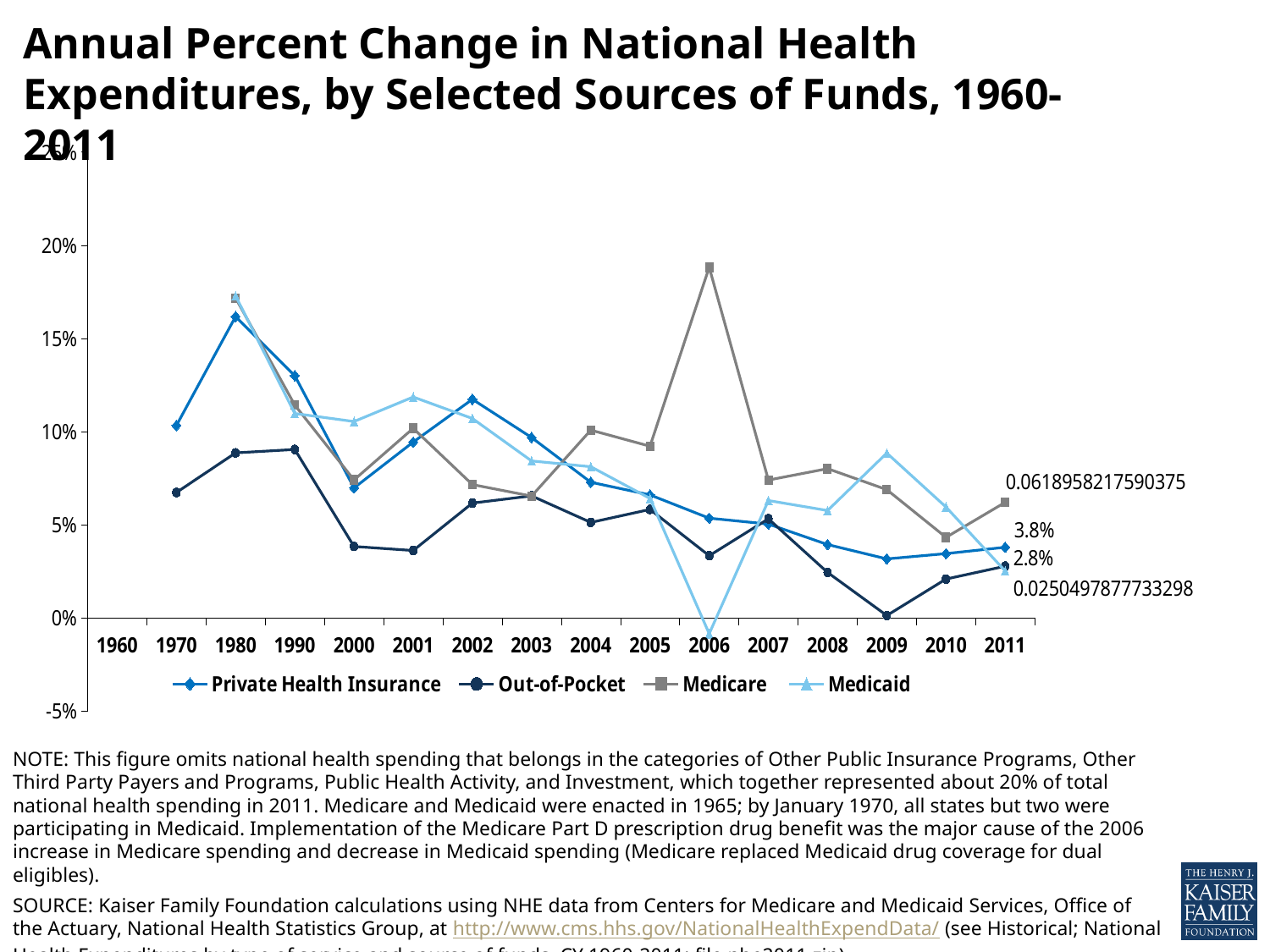
Is the value for Medicare in 2006 greater or less than 15%? greater Is the value for Out-of-Pocket in 2009 greater or less than 5%? less What is the difference between the 2011 values for Private Health Insurance (3.8%) and Out-of-Pocket (2.8%)? 1.0% Which series has the highest value in 2006? Medicare How many year labels are shown on the x axis? 16 What is the data label shown for Medicare in 2011? 0.0618958217590375 Which series has the lowest value in 2006? Medicaid What type of chart is shown on the slide? line chart What is the data label shown for Out-of-Pocket in 2011? 2.8% In 1970, which is larger: the value for Private Health Insurance or the value for Out-of-Pocket? Private Health Insurance What is the data label shown for Private Health Insurance in 2011? 3.8% How many series does the legend list? 4